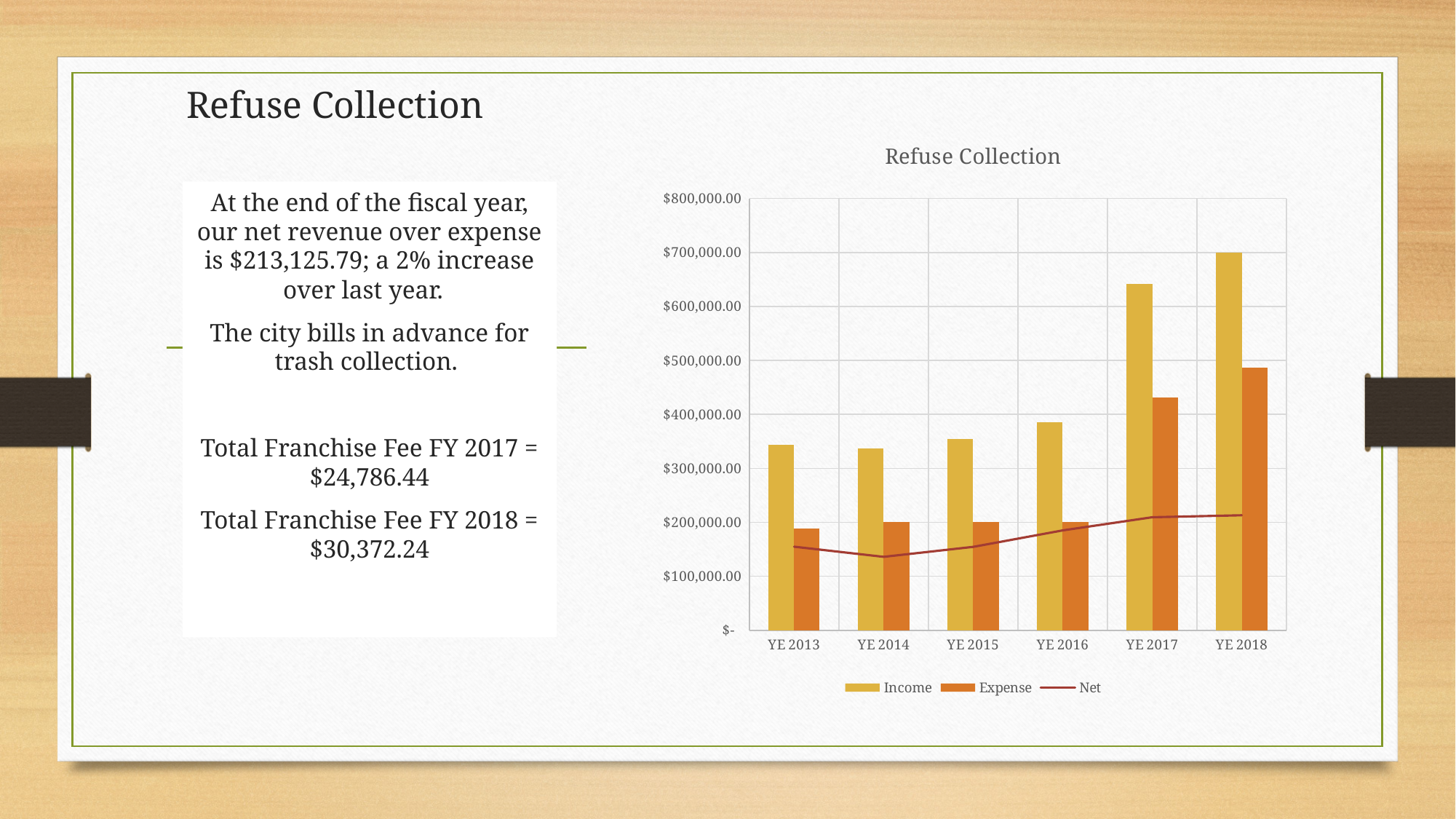
Does the Net line rise or fall from YE 2014 to YE 2018? rise What kind of chart is shown on the slide? bar chart (with a line for Net) In which year is the Net line at its lowest point? YE 2014 Which is larger for YE 2018, Income or Expense? Income Which year has the highest Expense? YE 2018 How many series does the chart legend list? 3 What is the title of the chart? Refuse Collection Which year has the highest Income? YE 2018 Is the Income value for YE 2016 greater or less than $400,000.00? less Is the Expense value for YE 2018 greater or less than $500,000.00? less How many year-end categories are shown on the x axis? 6 Is the Income value for YE 2017 greater or less than $600,000.00? greater